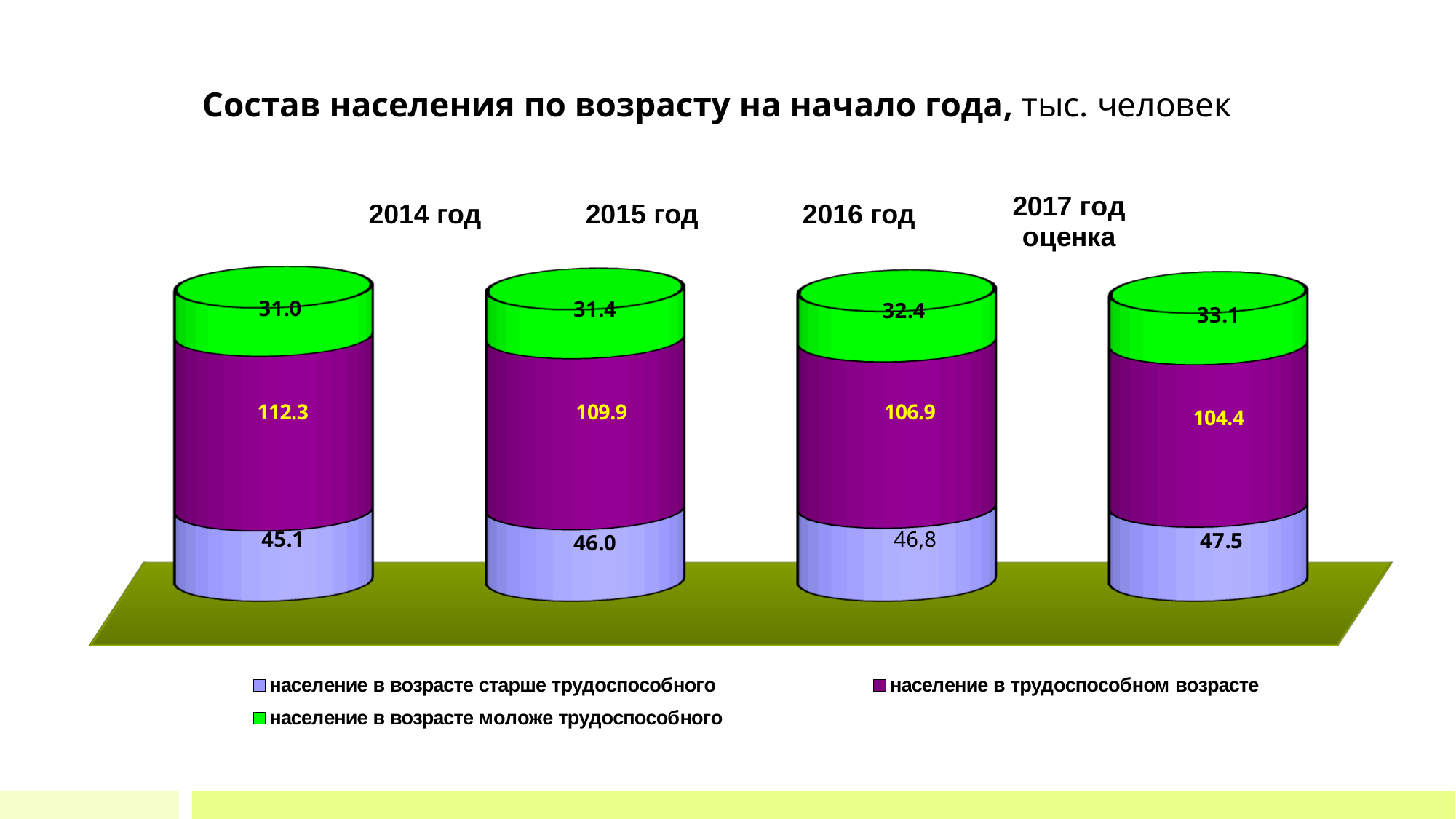
What is the difference between the население в трудоспособном возрасте values for 2014 год and 2017 год оценка? 7.9 What is the value for население в возрасте старше трудоспособного in 2016 год? 46,8 What kind of chart is shown on the slide? Stacked bar chart What is the value for население в трудоспособном возрасте in 2014 год? 112.3 How many series does the legend list? 3 Does the value for население в трудоспособном возрасте rise or fall from 2014 год to 2017 год оценка? Fall What is the total of the stacked bar for 2015 год? 187.3 What is the value for население в возрасте моложе трудоспособного in 2017 год оценка? 33.1 In which year is the value for население в возрасте старше трудоспособного the lowest? 2014 год How many years (categories) are shown on the chart? 4 Which is larger: the население в возрасте моложе трудоспособного value for 2015 год or for 2016 год? 2016 год In which year is the value for население в трудоспособном возрасте the highest? 2014 год